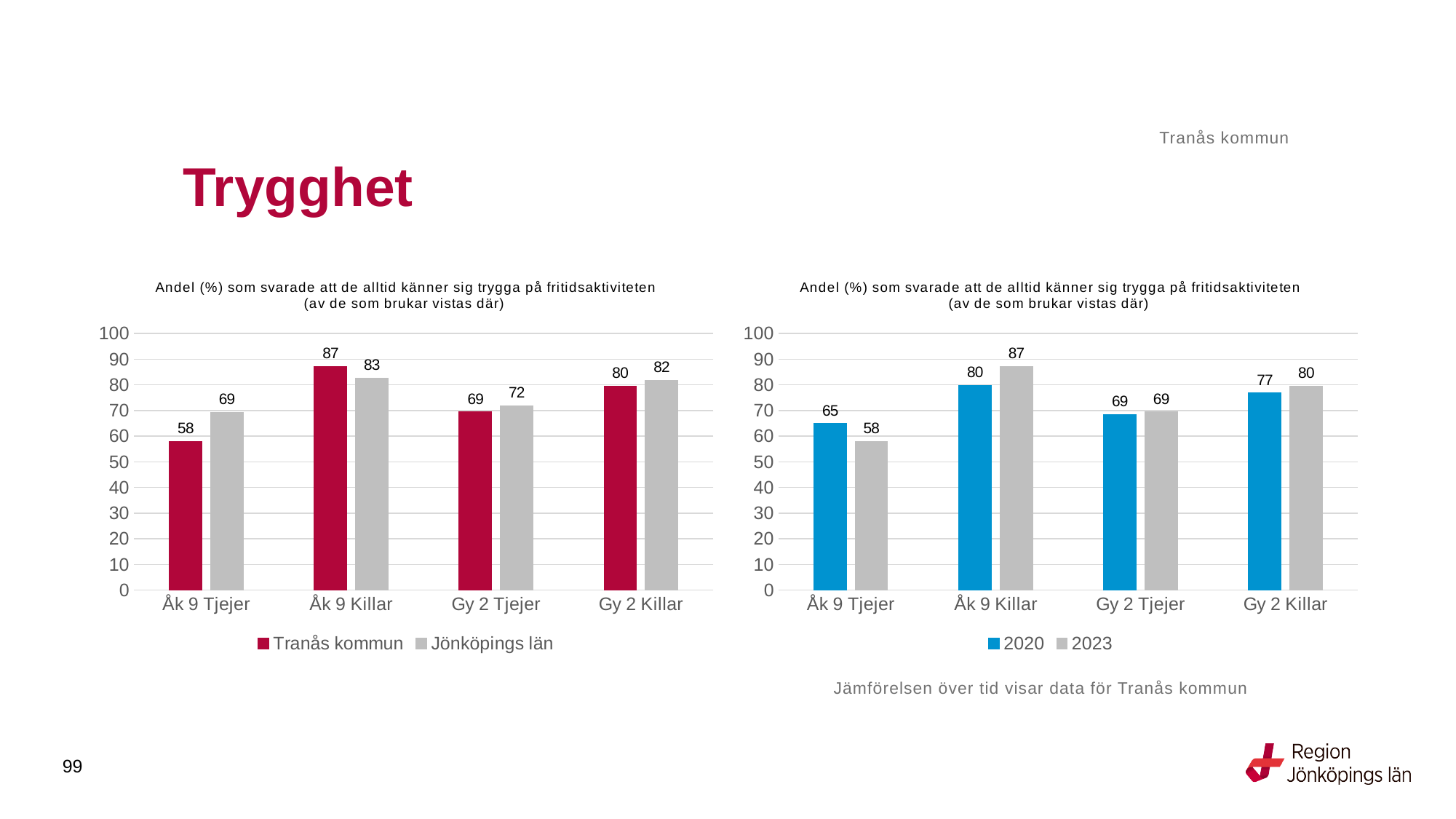
What kind of chart is the left chart? Bar chart In the left chart, which category has the lowest value for Jönköpings län? Åk 9 Tjejer In the left chart, what is the difference between Jönköpings län and Tranås kommun for Åk 9 Tjejer? 11 In the left chart, which is larger for Åk 9 Killar: Tranås kommun or Jönköpings län? Tranås kommun In the right chart, what is the value for 2023 for Åk 9 Killar? 87 In the left chart, which category has the highest value for Tranås kommun? Åk 9 Killar In the right chart, what is the value for 2020 for Gy 2 Killar? 77 How many categories are shown on the x axis of the right chart? 4 In the left chart, what is the value for Tranås kommun for Åk 9 Tjejer? 58 In the left chart, what is the value for Jönköpings län for Gy 2 Tjejer? 72 In the right chart, what is the difference between 2020 and 2023 for Åk 9 Tjejer? 7 In the right chart, which category has the lowest value for 2020? Åk 9 Tjejer